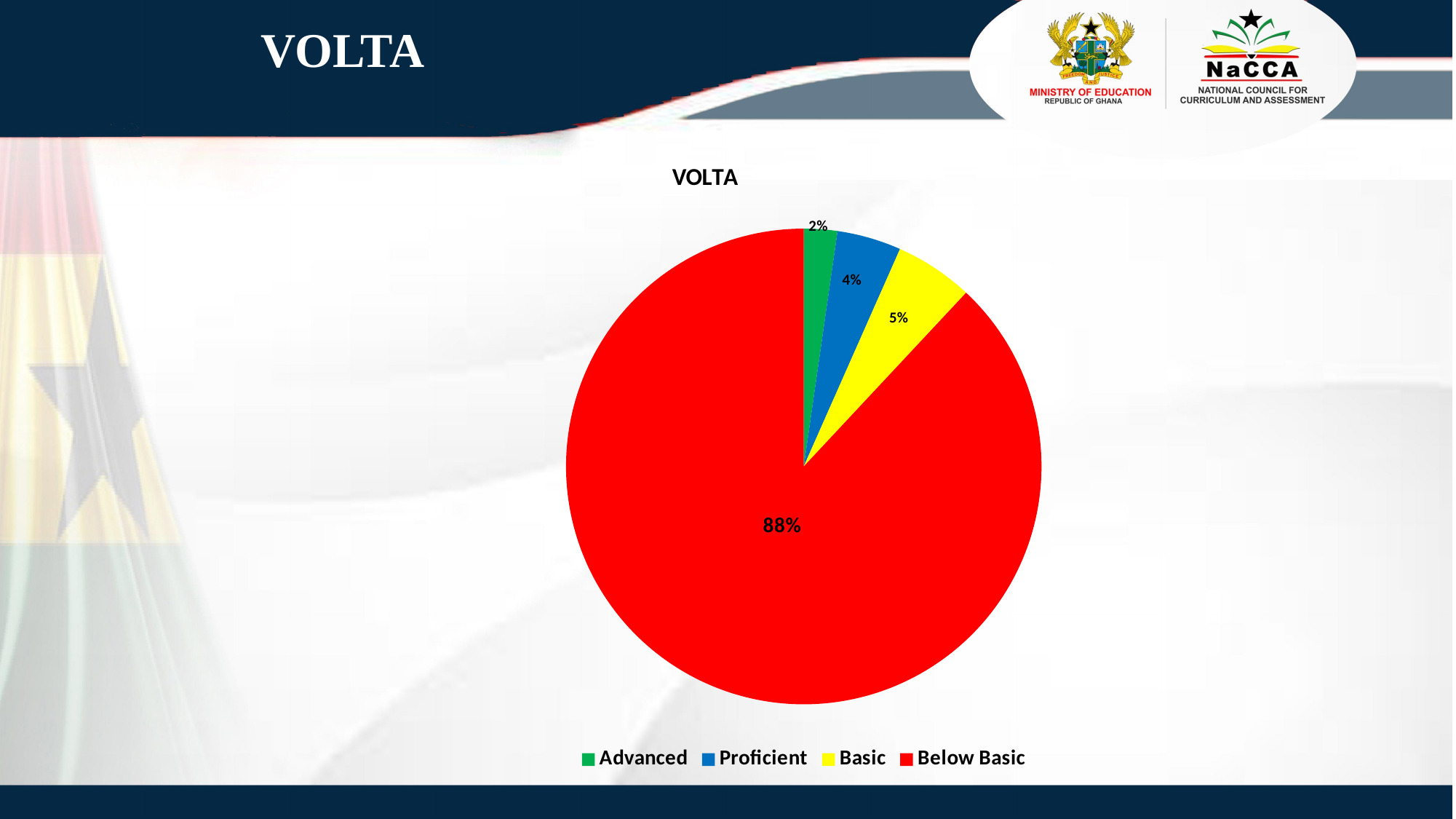
What is the difference between the Below Basic and Basic values? 83% Which category has the largest slice? Below Basic Which category has the smallest slice? Advanced What colour is the Below Basic slice? red What is the value for Basic? 5% What is the value for Proficient? 4% Which is larger, Proficient or Basic? Basic What is the value for Advanced? 2% What is the title of the chart? VOLTA What kind of chart is shown on the slide? pie chart What share of the pie is Below Basic? 88% How many categories does the legend list? 4